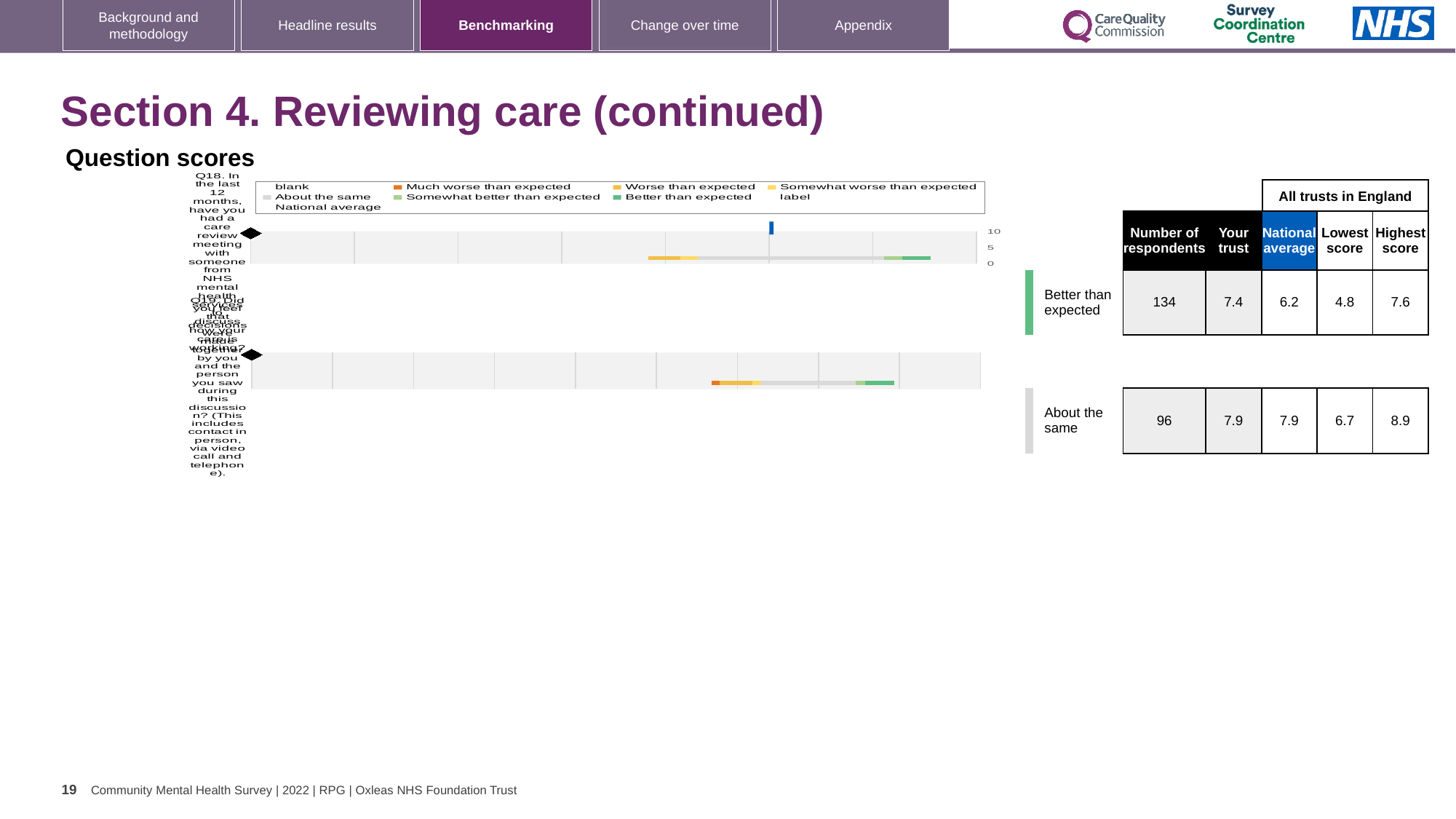
In the table beside the chart, what is the 'Your trust' score for Q19? 7.9 In the table beside the chart, which question has the larger number of respondents, Q18 or Q19? Q18 How many questions (bars) are plotted in the question scores chart? 2 What kind of chart is used to show the question scores on this slide? bar chart What colour is the 'Better than expected' entry in the chart legend? green In the table beside the chart, what is the number of respondents for Q18? 134 In the table beside the chart, what is the national average for Q18? 6.2 According to the label beside the chart, how is the trust's Q18 score categorised? Better than expected In the table beside the chart, what is the highest score among all trusts in England for Q19? 8.9 How many entries does the legend of the question scores chart list? 9 In the table beside the chart, what is the difference between the 'Your trust' score and the national average for Q18? 1.2 What is the highest value shown on the chart's score axis? 10